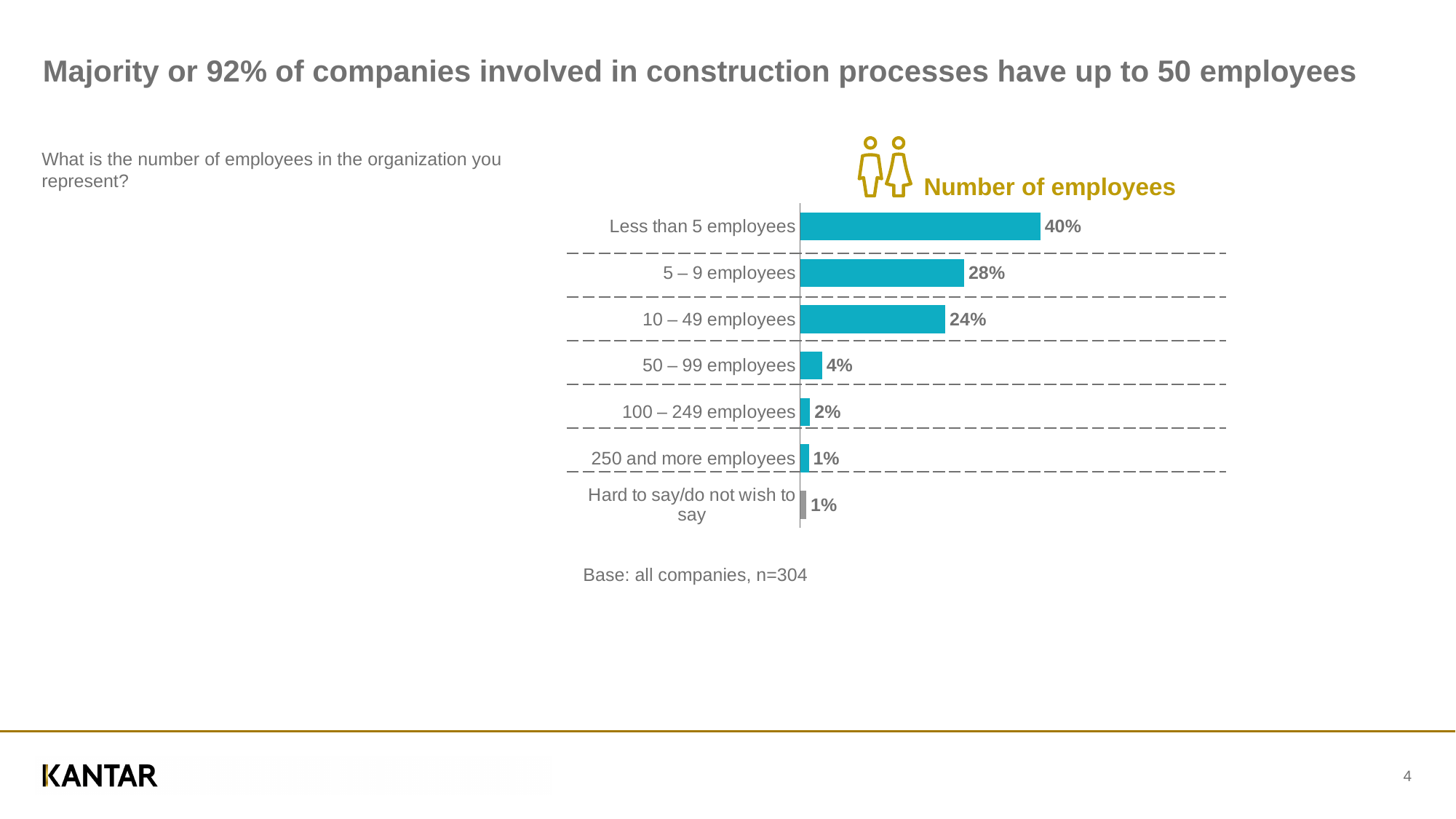
Which category has the highest value? Less than 5 employees What percentage of companies have less than 5 employees? 40% What is the difference between the values for 5 – 9 employees and 10 – 49 employees? 4% What is the difference between the values for Less than 5 employees and 5 – 9 employees? 12% What is the value for 10 – 49 employees? 24% What percentage of companies have 50 – 99 employees? 4% How many categories are shown in the chart? 7 What is the base (sample size) stated below the chart? n=304 What is the value for 100 – 249 employees? 2% What is the title of the chart? Number of employees What kind of chart is shown on the slide? Bar chart Which is larger, the value for 50 – 99 employees or the value for 100 – 249 employees? 50 – 99 employees